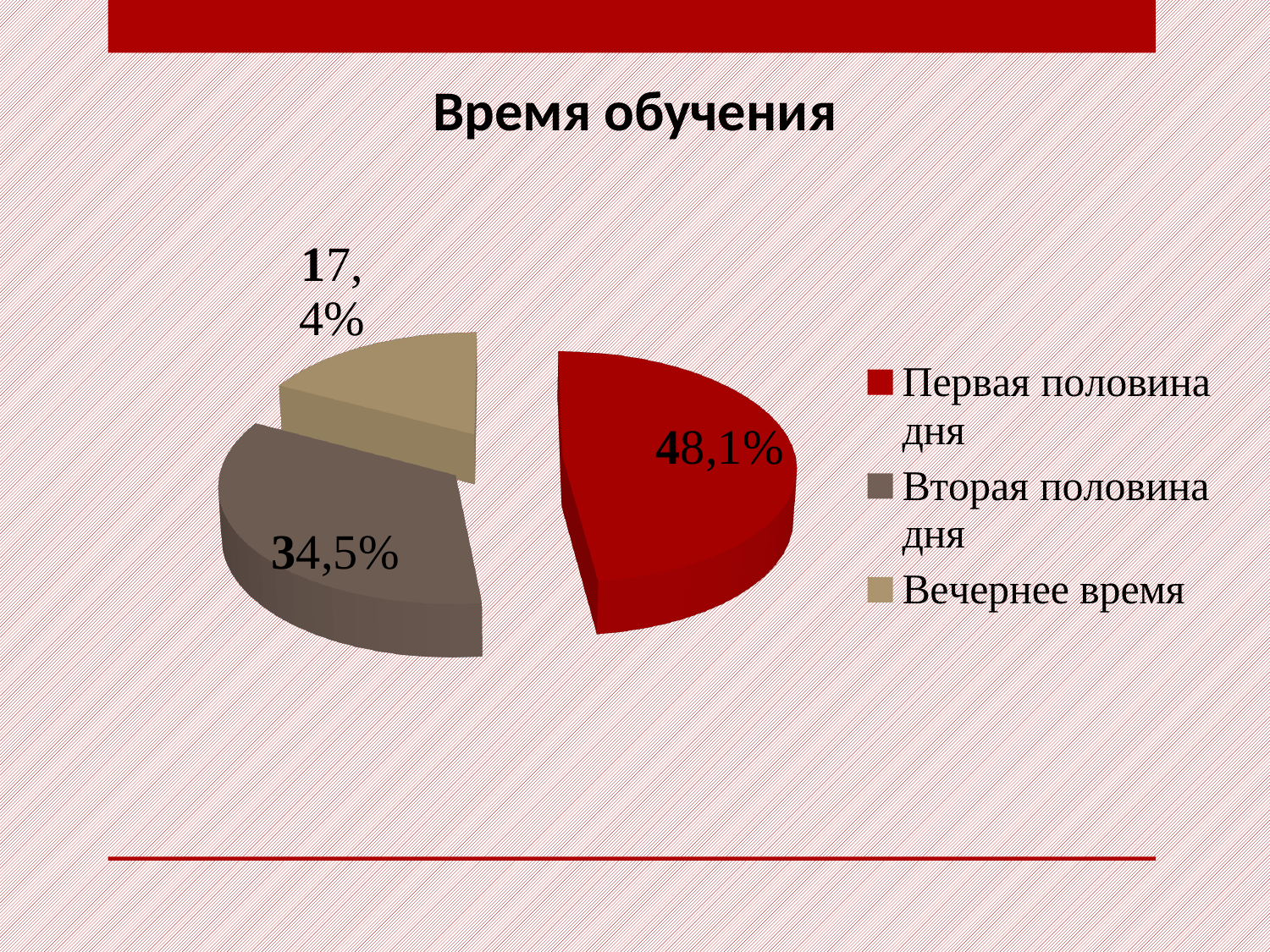
What percentage is shown for Первая половина дня? 48,1% What is the title of the chart? Время обучения What colour is the slice for Вечернее время? Beige (tan) What percentage is shown for Вторая половина дня? 34,5% What is the difference in percentage points between Первая половина дня and Вторая половина дня? 13,6 Which category has the smallest share of the pie? Вечернее время What percentage is shown for Вечернее время? 17,4% What type of chart is shown on the slide? Pie chart Which category has the largest share of the pie? Первая половина дня How many entries does the legend list? 3 Which is larger: the share for Вторая половина дня or the share for Вечернее время? Вторая половина дня How many slices does the pie chart have? 3